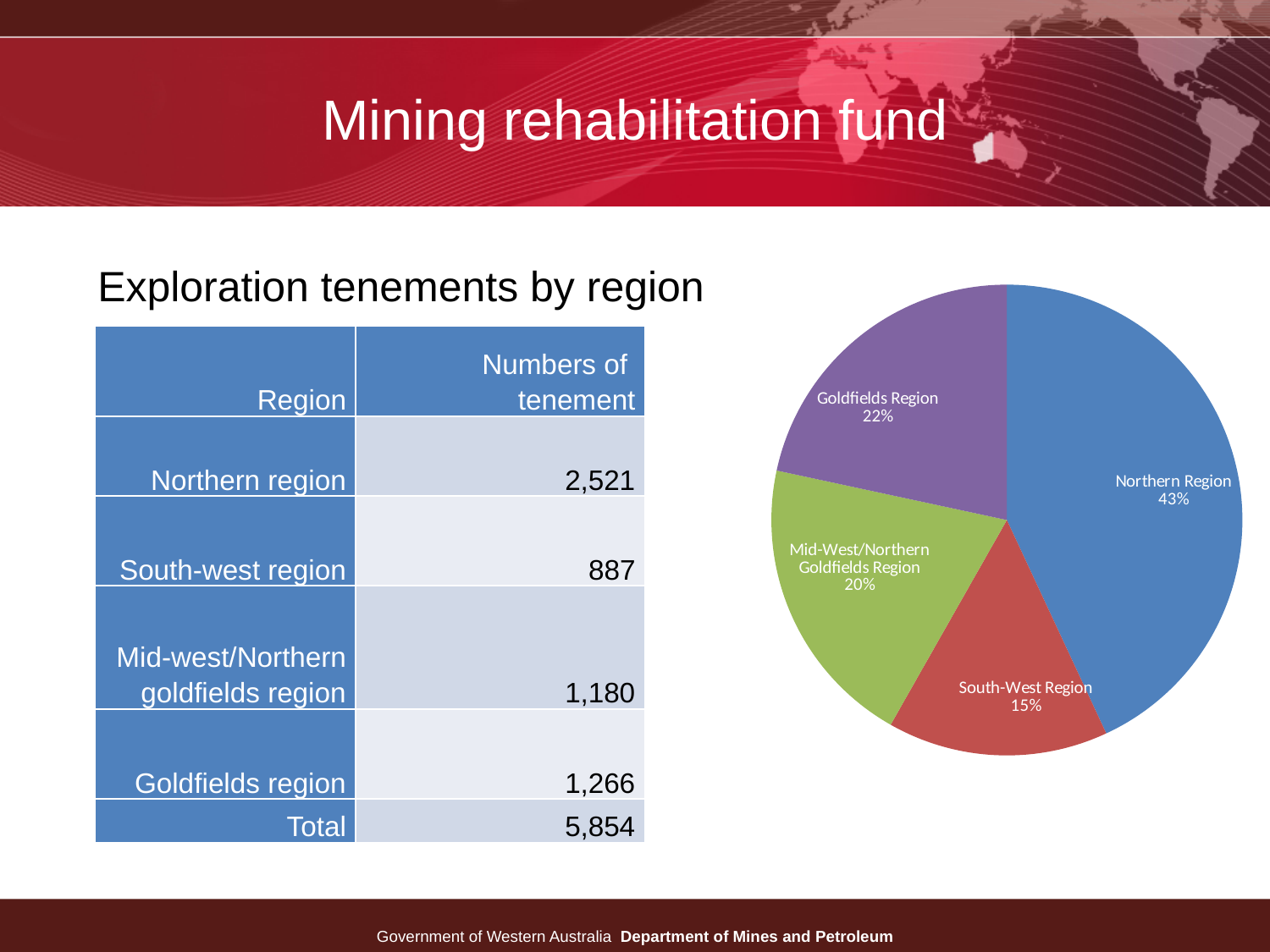
In the pie chart, what is the difference in percentage points between the Goldfields Region share and the Mid-West/Northern Goldfields Region share? 2 Which region has the smallest slice in the pie chart? South-West Region What share of the pie chart does the Mid-West/Northern Goldfields Region slice represent? 20% In the pie chart, what is the difference in percentage points between the Northern Region share and the South-West Region share? 28 What share of the pie chart does the Northern Region slice represent? 43% What share of the pie chart does the Goldfields Region slice represent? 22% How many slices does the pie chart have? 4 In the pie chart, which is larger: the Goldfields Region slice or the South-West Region slice? Goldfields Region What colour is the Northern Region slice in the pie chart? blue Which region has the largest slice in the pie chart? Northern Region What kind of chart is shown on the slide? pie chart